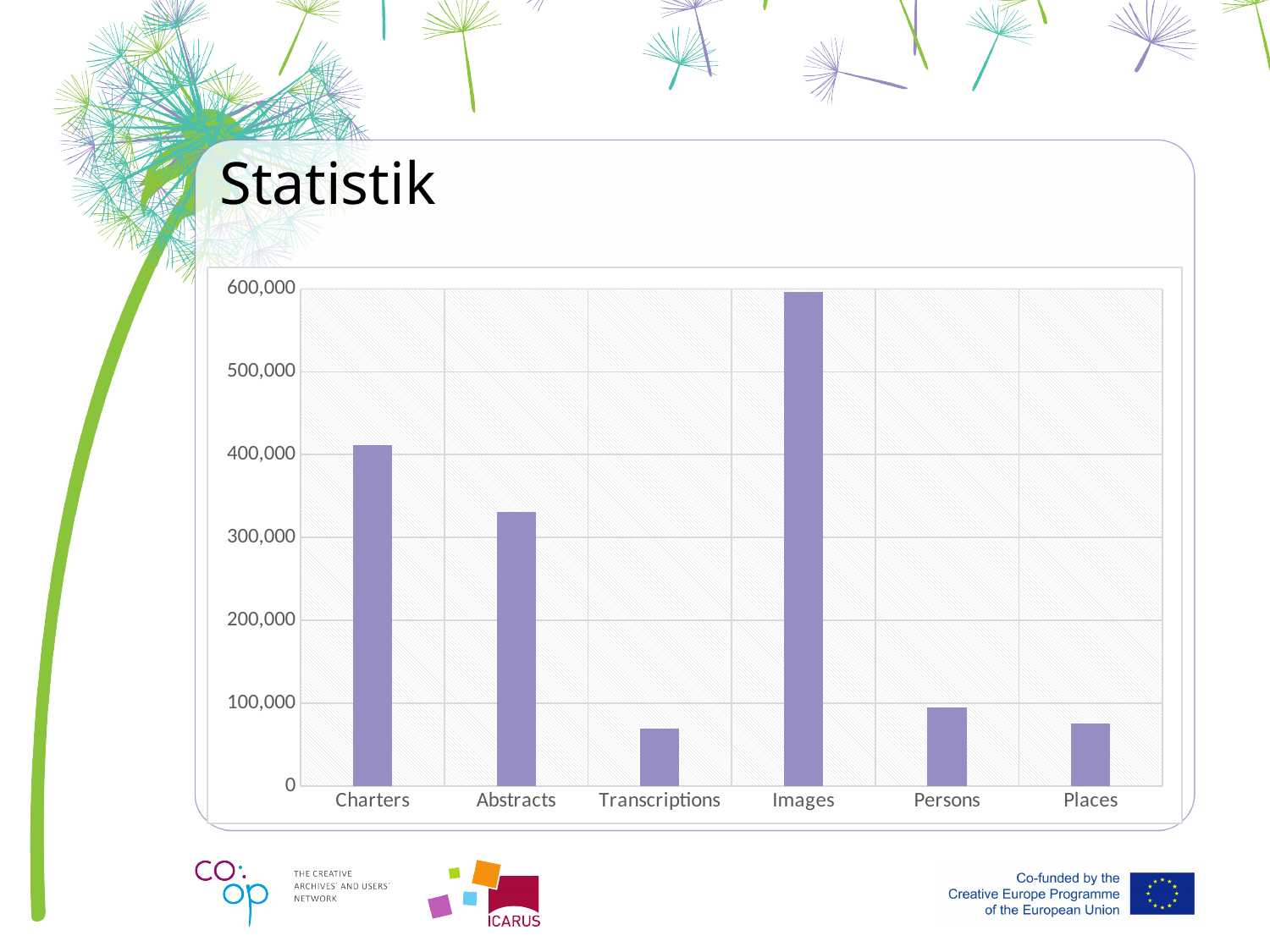
What is the title of the slide containing the chart? Statistik Is the value for Charters greater or less than 400,000? greater Is the value for Abstracts greater or less than 300,000? greater Which is larger, the value for Persons or the value for Images? Images What kind of chart is shown on the slide? bar chart Which category has the highest value in the chart? Images Is the value for Images greater or less than 500,000? greater Which is larger, the value for Abstracts or the value for Places? Abstracts Which is larger, the value for Charters or the value for Abstracts? Charters How many categories are shown on the x axis of the chart? 6